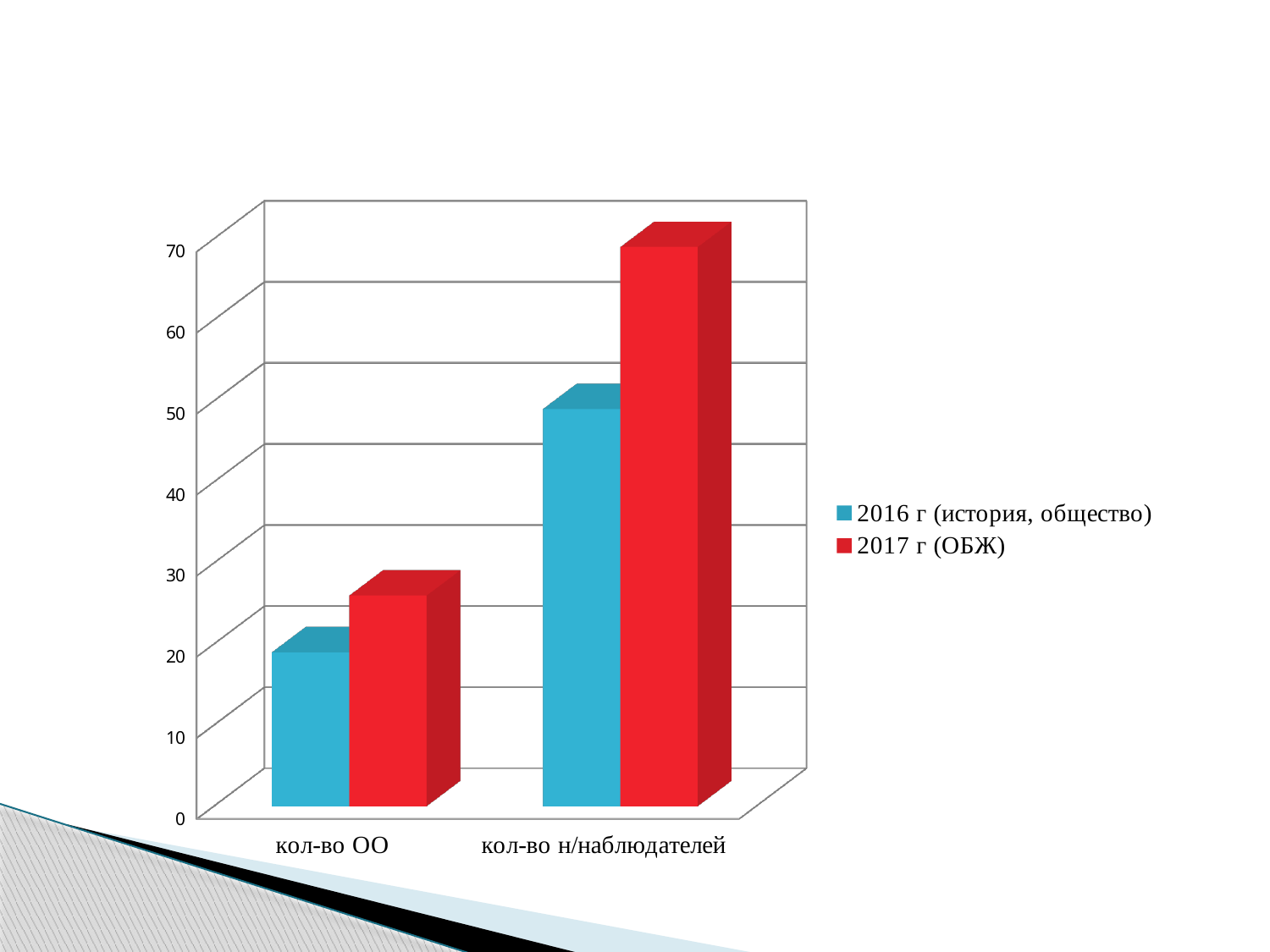
Is the value for кол-во ОО in the 2017 г (ОБЖ) series greater or less than 30? less Which category has the highest value for the 2017 г (ОБЖ) series? кол-во н/наблюдателей For кол-во н/наблюдателей, which series has the larger value, 2016 г (история, общество) or 2017 г (ОБЖ)? 2017 г (ОБЖ) Which series is shown in red? 2017 г (ОБЖ) For кол-во ОО, which series has the larger value, 2016 г (история, общество) or 2017 г (ОБЖ)? 2017 г (ОБЖ) Is the value for кол-во н/наблюдателей in the 2017 г (ОБЖ) series greater or less than 60? greater How many categories are shown on the x axis? 2 How many series does the legend list? 2 What kind of chart is shown on the slide? bar chart Which category has the lowest value for the 2016 г (история, общество) series? кол-во ОО Is the value for кол-во н/наблюдателей in the 2016 г (история, общество) series greater or less than 40? greater Which series is shown in blue? 2016 г (история, общество)